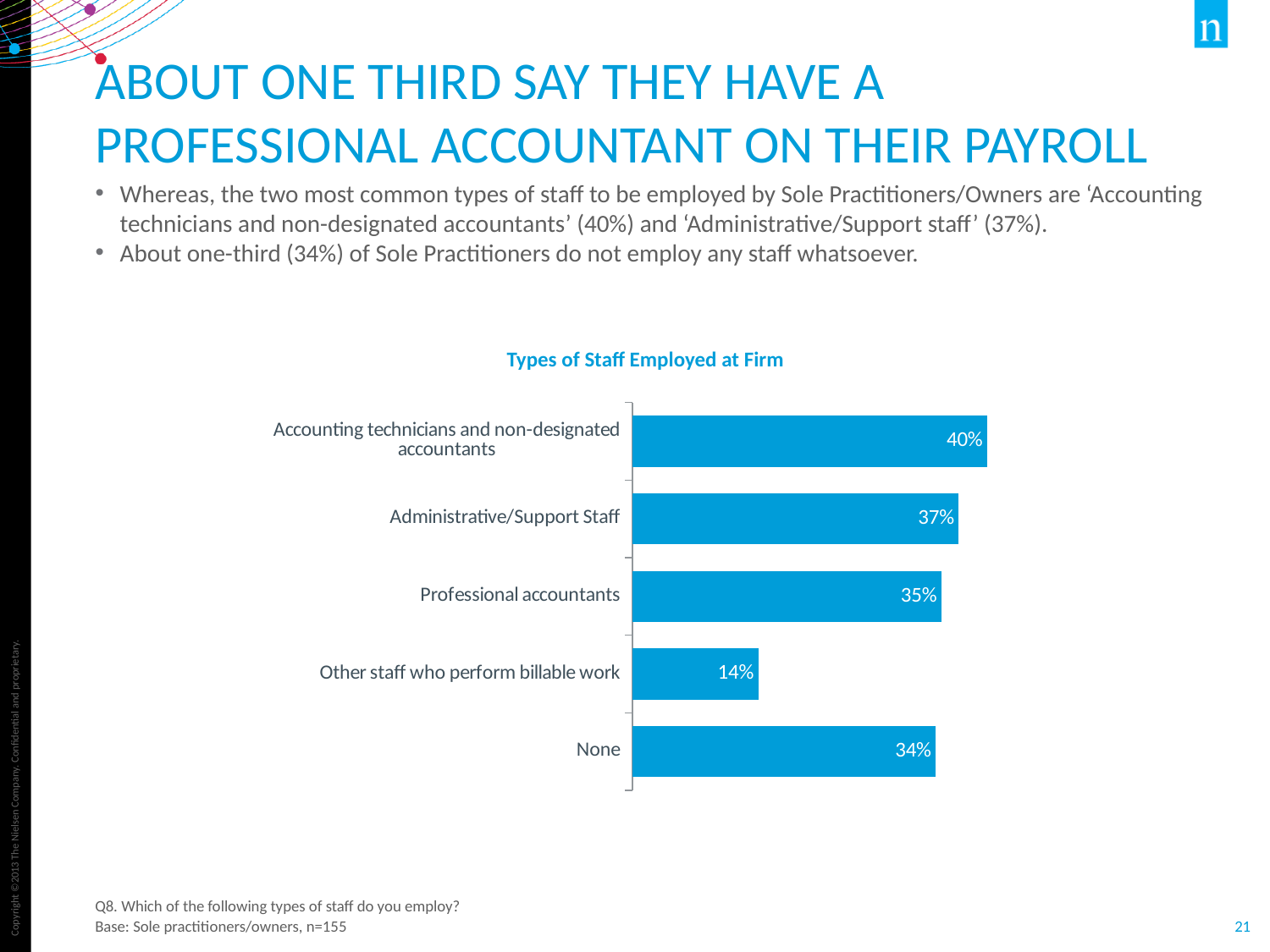
What is the title of the chart? Types of Staff Employed at Firm Which category has the highest value in the chart? Accounting technicians and non-designated accountants What is the value for 'Professional accountants' in the Types of Staff Employed at Firm chart? 35% How many categories are shown in the chart? 5 Which is larger: the value for 'Professional accountants' or the value for 'None'? Professional accountants What is the value shown for 'None'? 34% What is the difference between 'Administrative/Support Staff' and 'None'? 3% What is the difference between the values for 'Accounting technicians and non-designated accountants' and 'Other staff who perform billable work'? 26% What is the value for 'Other staff who perform billable work'? 14% Which category has the lowest value in the chart? Other staff who perform billable work What percentage of sole practitioners employ 'Administrative/Support Staff'? 37% What type of chart is shown on the slide? Bar chart